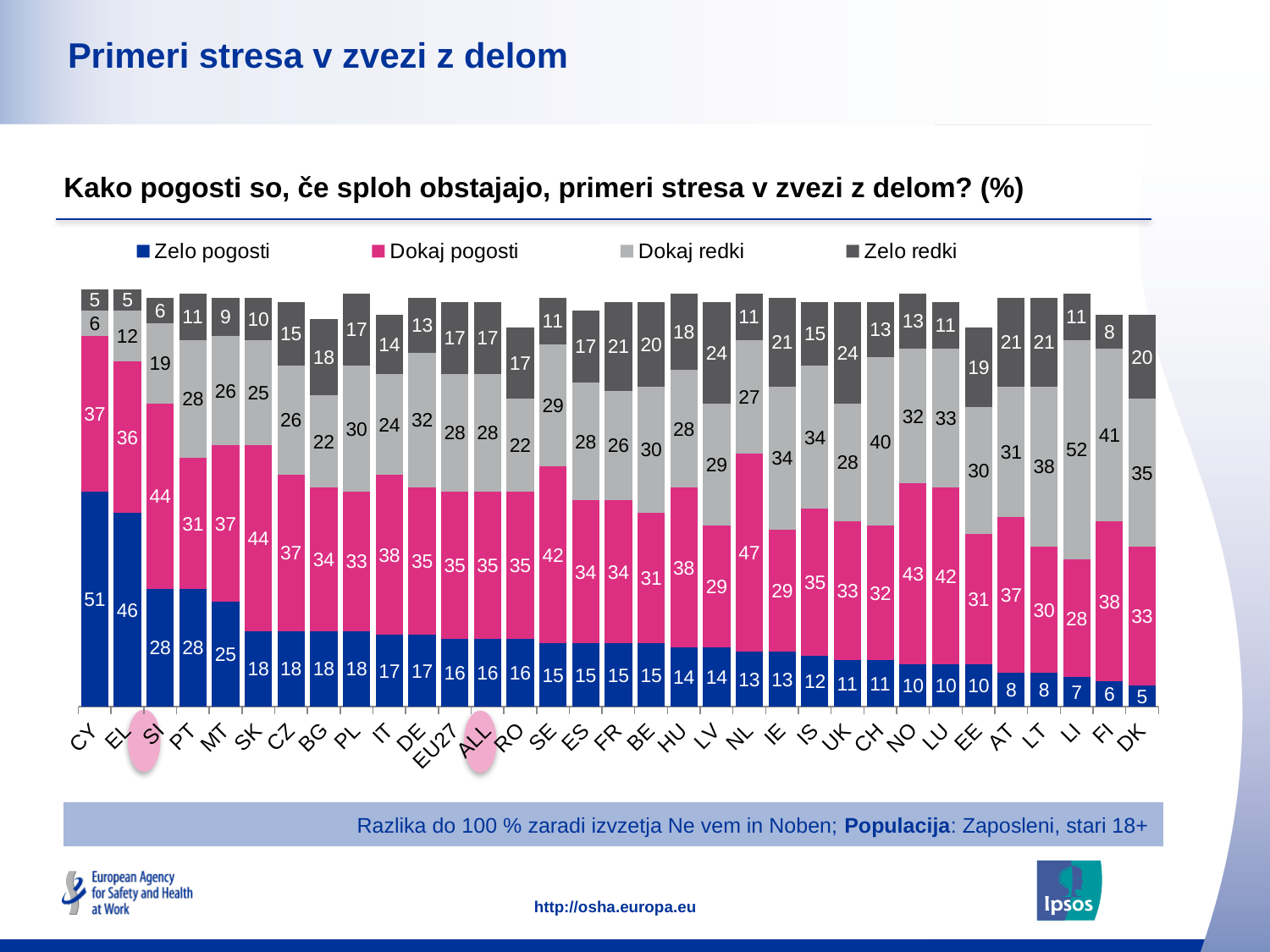
What is the 'Zelo pogosti' value for CY? 51 What type of chart is shown on the slide? Stacked bar chart Do the 'Zelo pogosti' values rise or fall from left to right along the x axis? Fall Which has a larger 'Zelo redki' value, LV or NL? LV Which country has the highest 'Zelo pogosti' value? CY Which country has the lowest 'Zelo pogosti' value? DK What is the 'Dokaj pogosti' value for NL? 47 How many series does the legend list? 4 What is the 'Dokaj redki' value for LI? 52 What is the total of the stacked bar for CY? 99 What is the difference between the 'Zelo pogosti' values for CY and EL? 5 How many countries/categories are shown along the x axis? 33